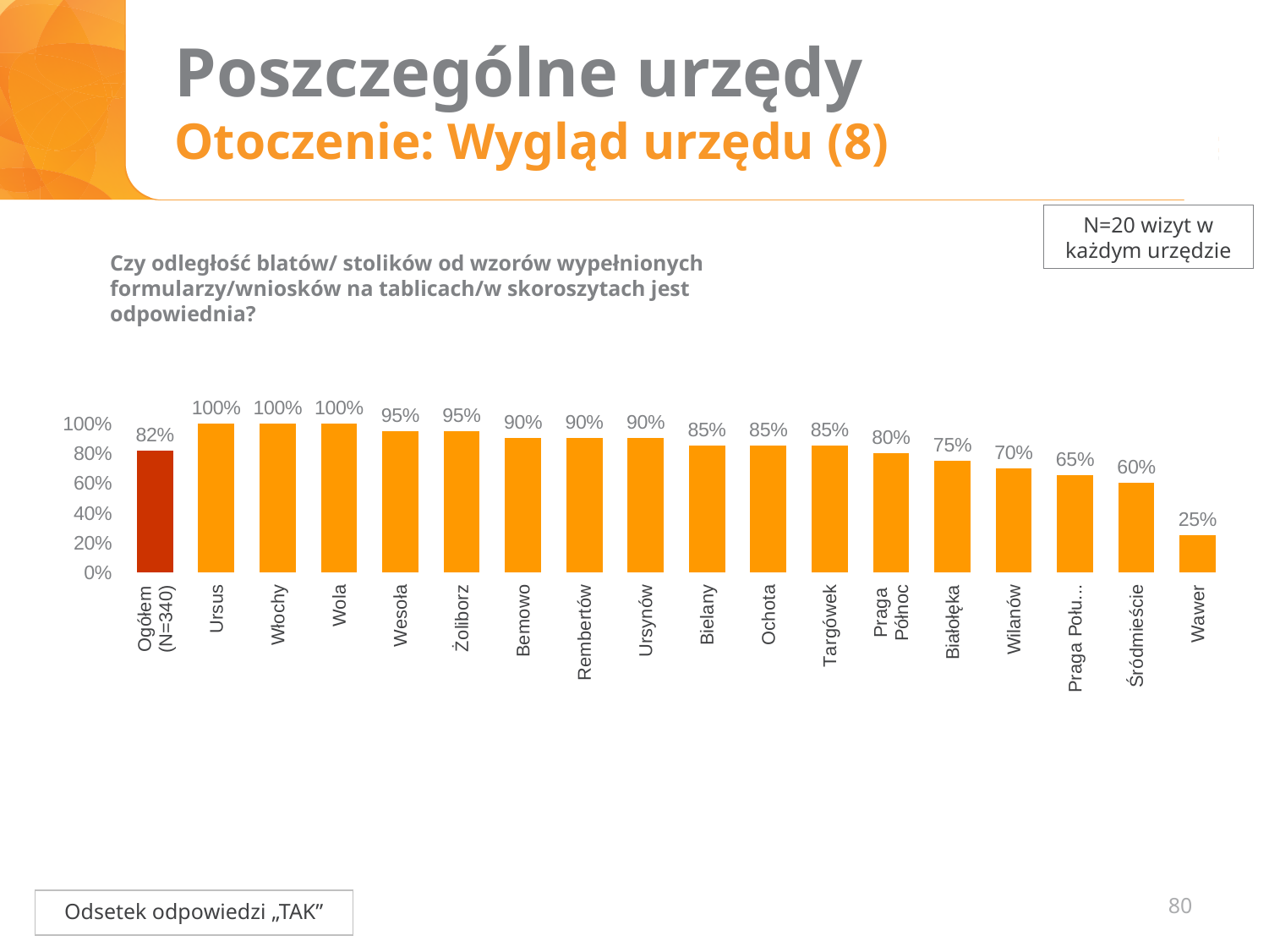
Do the values for the individual offices rise or fall from left to right after the Ogółem bar? Fall What is the value for Wawer? 25% What kind of chart is shown on the slide? Bar chart Which category has the lowest value? Wawer Which bar is shown in a different colour from the others? Ogółem (N=340) What is the difference between the values for Ogółem (N=340) and Wawer? 57 percentage points What is the value for Śródmieście? 60% What is the difference between the values for Ursus and Śródmieście? 40 percentage points What is the value for Ogółem (N=340)? 82% What is the value for Praga Północ? 80% How many bars are shown in the chart? 18 Which is larger, the value for Białołęka or the value for Wilanów? Białołęka